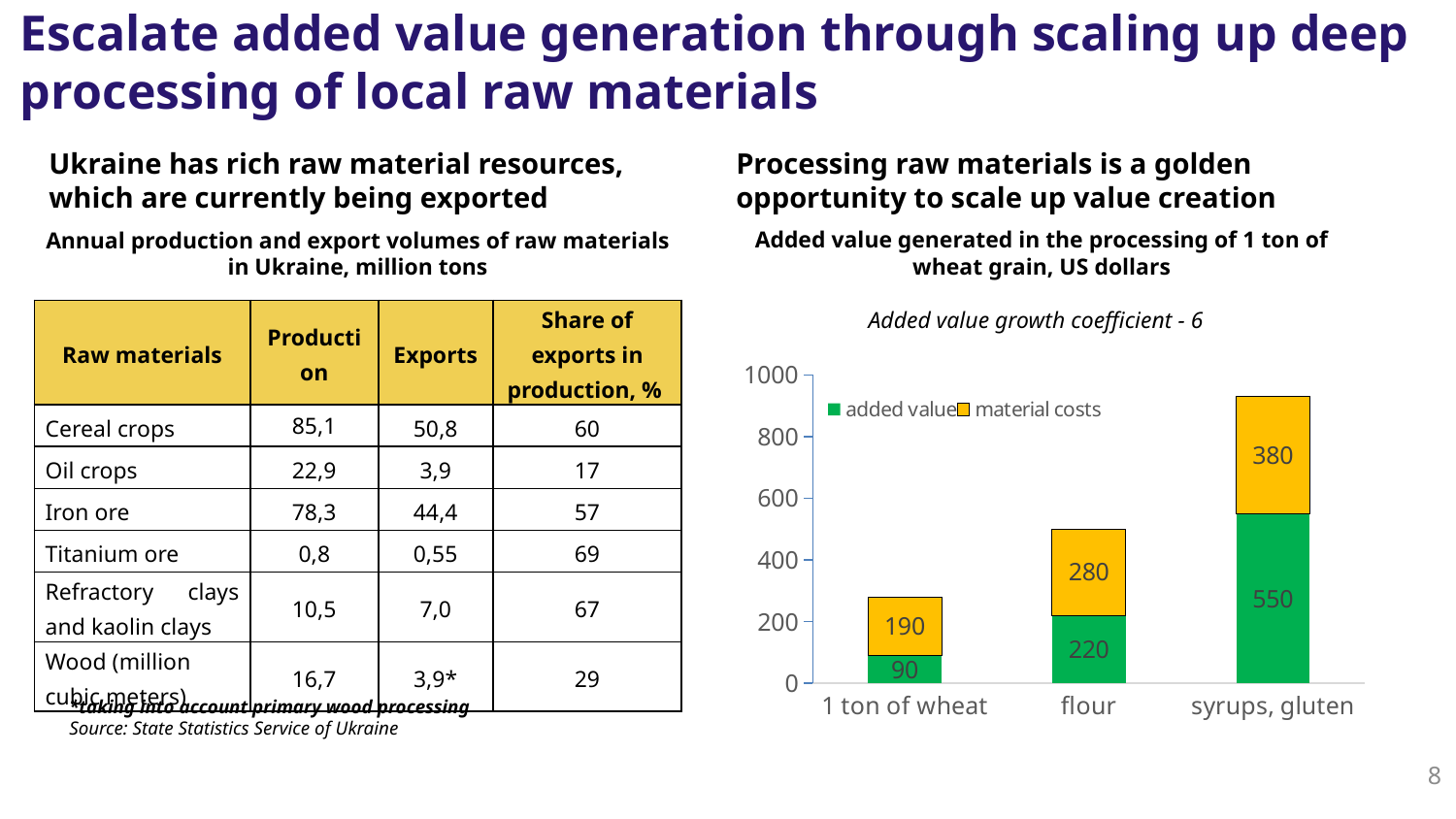
What is the added value for flour? 220 How many categories are shown on the x axis? 3 What is the added value for 1 ton of wheat? 90 What is the total of the stacked bar for syrups, gluten? 930 Which category has the lowest material costs? 1 ton of wheat Which is larger for flour: added value or material costs? material costs What is the difference between the added value for syrups, gluten and the added value for flour? 330 Which category has the highest added value? syrups, gluten How many series does the legend list? 2 What is the total of the stacked bar for 1 ton of wheat? 280 What kind of chart is shown on the slide? stacked bar chart What are the material costs for syrups, gluten? 380